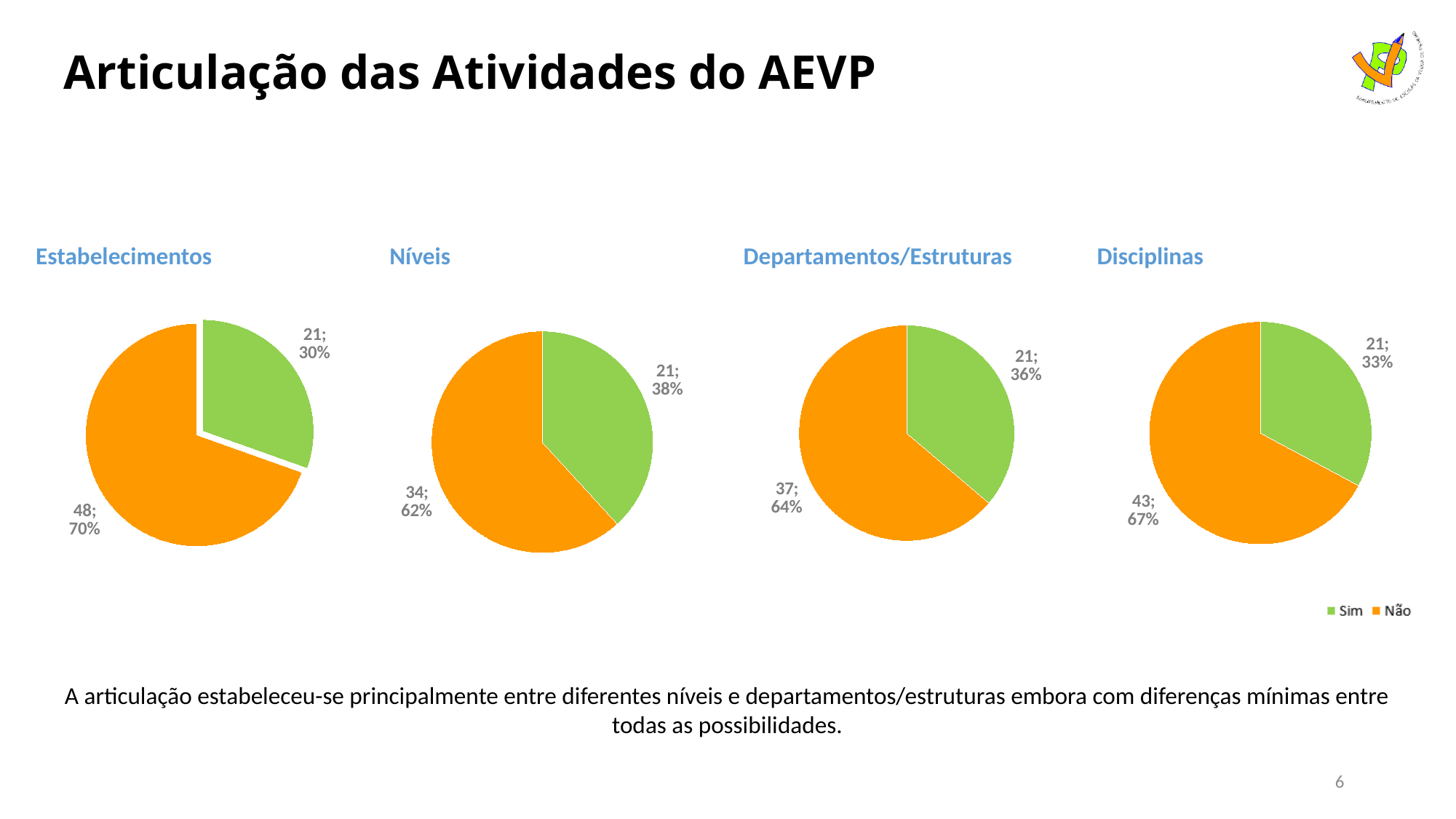
How many entries does the legend list for the pie charts? 2 In the Níveis pie chart, what share of the pie does Não represent? 62% In the Disciplinas pie chart, what share of the pie does Não represent? 67% In the Departamentos/Estruturas pie chart, what share of the pie does Sim represent? 36% What kind of chart is used for Disciplinas? Pie chart In the Estabelecimentos pie chart, what is the count for Não? 48 In the Níveis pie chart, what is the count for Não? 34 In the Níveis pie chart, which slice is larger, Sim or Não? Não In the Estabelecimentos pie chart, what is the difference between the Não count and the Sim count? 27 In the Departamentos/Estruturas pie chart, what is the count for Não? 37 In the Disciplinas pie chart, what is the count for Não? 43